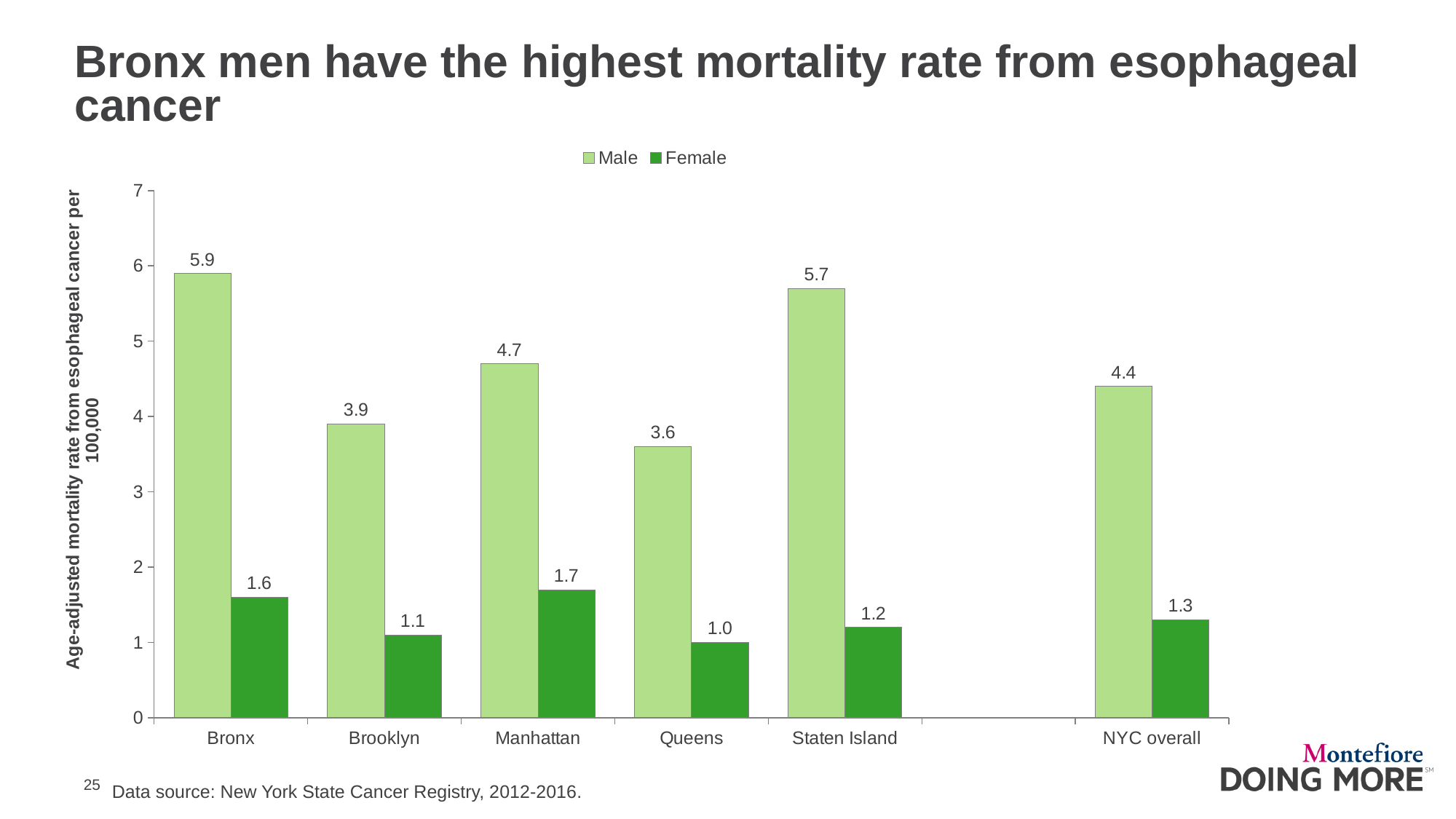
Is the Male mortality rate for Manhattan greater or less than 4? greater What is the Male mortality rate for the Bronx? 5.9 How many series does the legend list? 2 How many categories are shown on the x axis? 6 Which borough has the highest Male mortality rate? Bronx What kind of chart is shown on the slide? bar chart What is the Male mortality rate for NYC overall? 4.4 What is the difference between the Male and Female mortality rates for Staten Island? 4.5 Which borough has the lowest Female mortality rate? Queens What is the data source cited on the slide? New York State Cancer Registry, 2012-2016 What is the Female mortality rate for Manhattan? 1.7 Which is larger, the Male rate for Brooklyn or the Male rate for Queens? Brooklyn